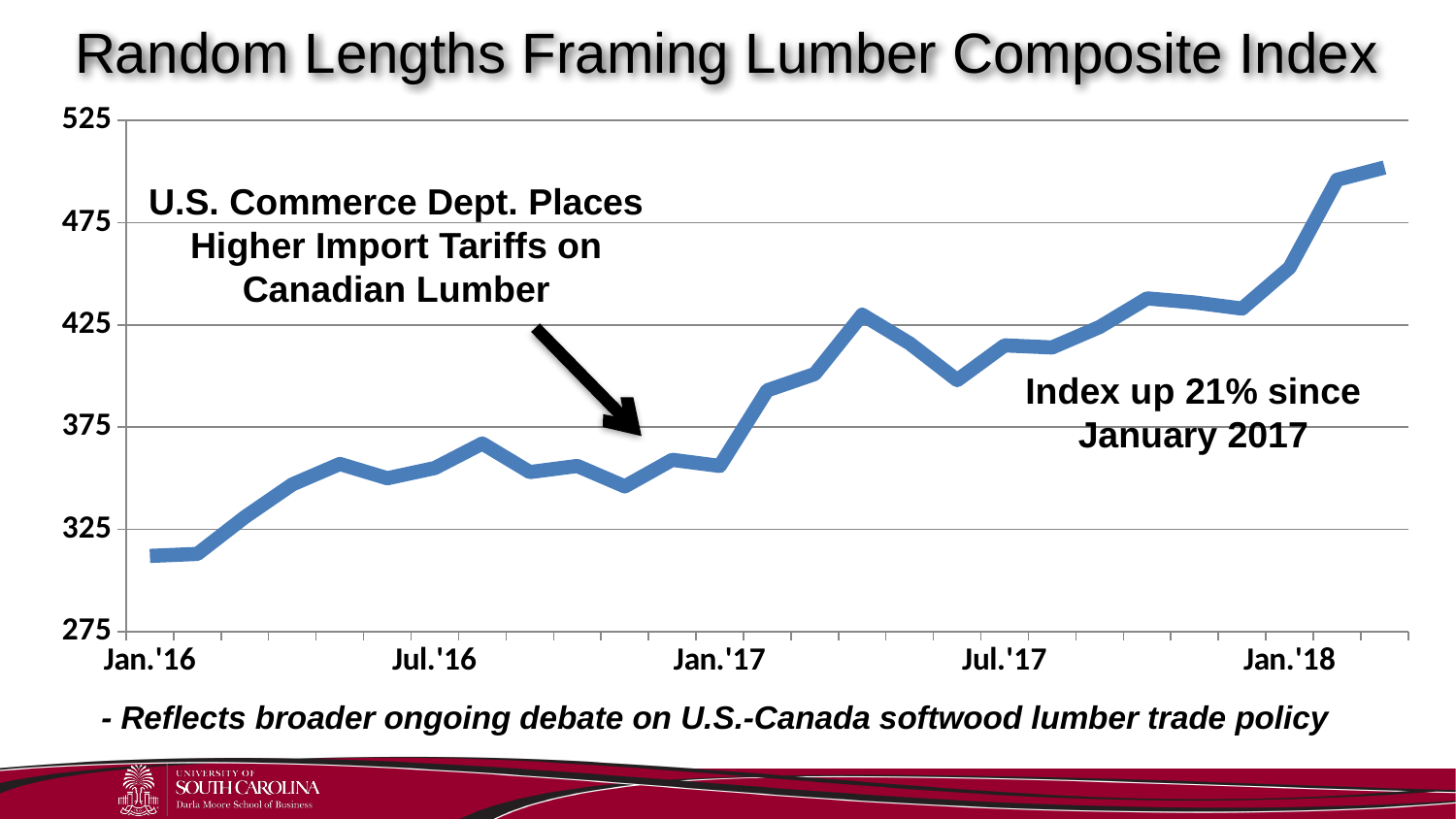
Is the value at Jan.'18 greater or less than 425? greater Is the value at Jul.'16 greater or less than 375? less Is the value at Jan.'16 greater or less than 325? less What is the title of the chart? Random Lengths Framing Lumber Composite Index What kind of chart is shown on the slide? line chart Which of the labeled x-axis dates has the highest index value? Jan.'18 According to the annotation on the chart, by what percentage is the index up since January 2017? 21% Overall, does the index rise or fall from Jan.'16 to the end of the series? rise Which is larger, the value at Jan.'17 or the value at Jul.'17? Jul.'17 Which of the labeled x-axis dates has the lowest index value? Jan.'16